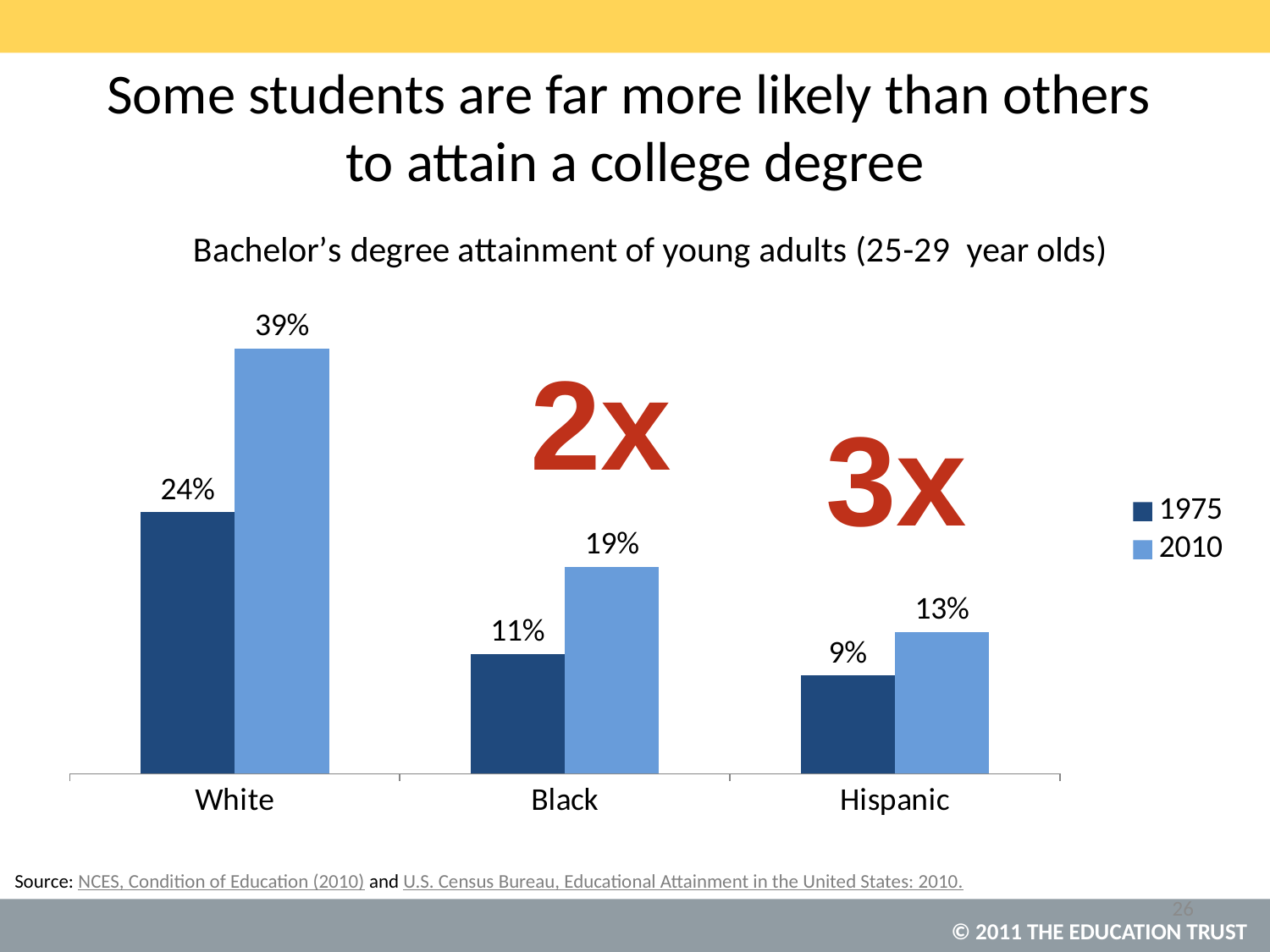
How many groups are shown on the x axis? 3 Which is larger: the 1975 value for White young adults or the 2010 value for Black young adults? 1975 value for White What kind of chart is shown on the slide? Bar chart What is the bachelor's degree attainment for Black young adults in 1975? 11% What is the difference between the 2010 values for Black and Hispanic young adults? 6% Which group has the lowest bachelor's degree attainment in 1975? Hispanic What is the bachelor's degree attainment for Hispanic young adults in 2010? 13% What is the bachelor's degree attainment for White young adults in 2010? 39% Which group has the highest bachelor's degree attainment in 2010? White What are the two series listed in the legend? 1975 and 2010 What is the difference between the 2010 and 1975 values for White young adults? 15% How many series does the legend list? 2